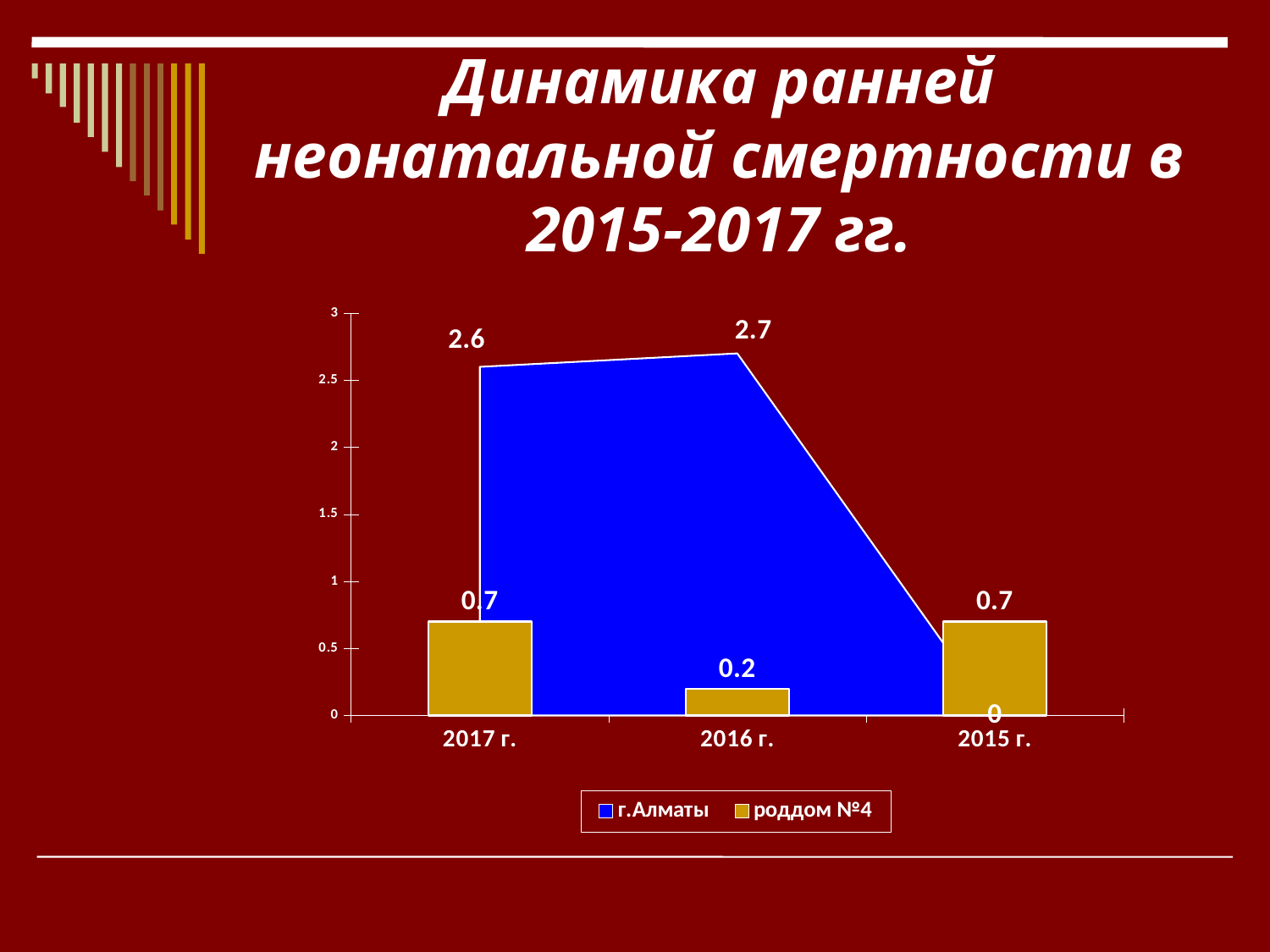
What is the value for г.Алматы in 2016 г.? 2.7 In which year is the value for г.Алматы the highest? 2016 г. In which year is the value for роддом №4 the lowest? 2016 г. What is the value for г.Алматы in 2017 г.? 2.6 What colour represents г.Алматы in the chart? Blue How many series does the legend list? 2 What is the value for роддом №4 in 2016 г.? 0.2 What is the difference between the г.Алматы and роддом №4 values in 2016 г.? 2.5 What is the value for г.Алматы in 2015 г.? 0 How many years are shown on the x axis? 3 What is the value for роддом №4 in 2015 г.? 0.7 Which is larger in 2017 г., the value for г.Алматы or for роддом №4? г.Алматы